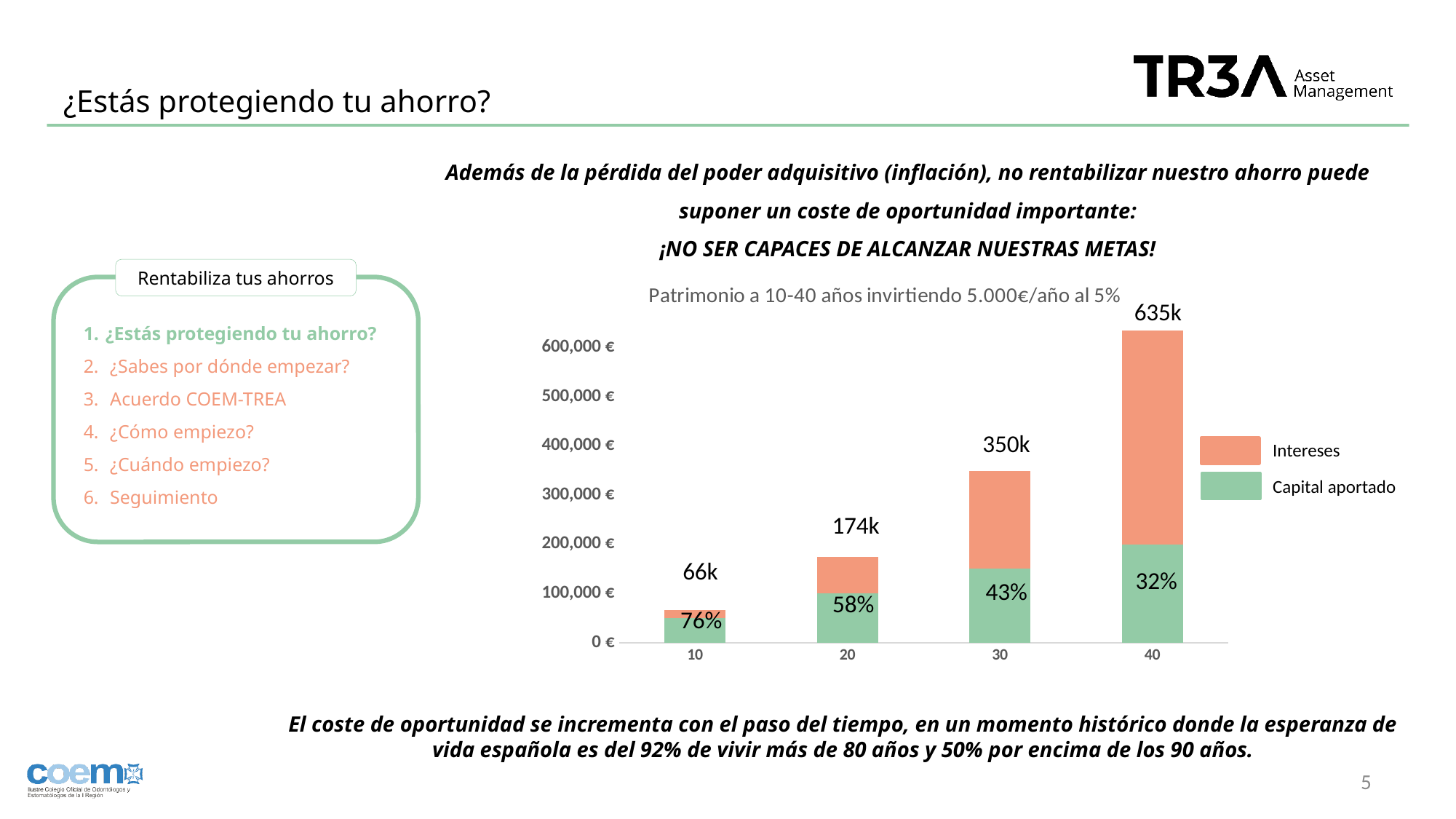
How many series does the legend list? 2 Is the total value for 30 years greater or less than 300,000 €? greater What percentage is printed on the Capital aportado segment of the 20-year bar? 58% Which year category has the lowest total patrimonio? 10 What is the total value labelled above the bar for 40 years? 635k What is the total value labelled above the bar for 10 years? 66k Which is larger, the total for 20 years or the total for 30 years? 30 years How many year categories are shown on the x axis? 4 What percentage is printed on the Capital aportado segment of the 30-year bar? 43% What kind of chart is shown on the slide? Stacked bar chart What is the difference between the total labelled for 40 years and the total labelled for 30 years? 285k Which year category has the highest total patrimonio? 40